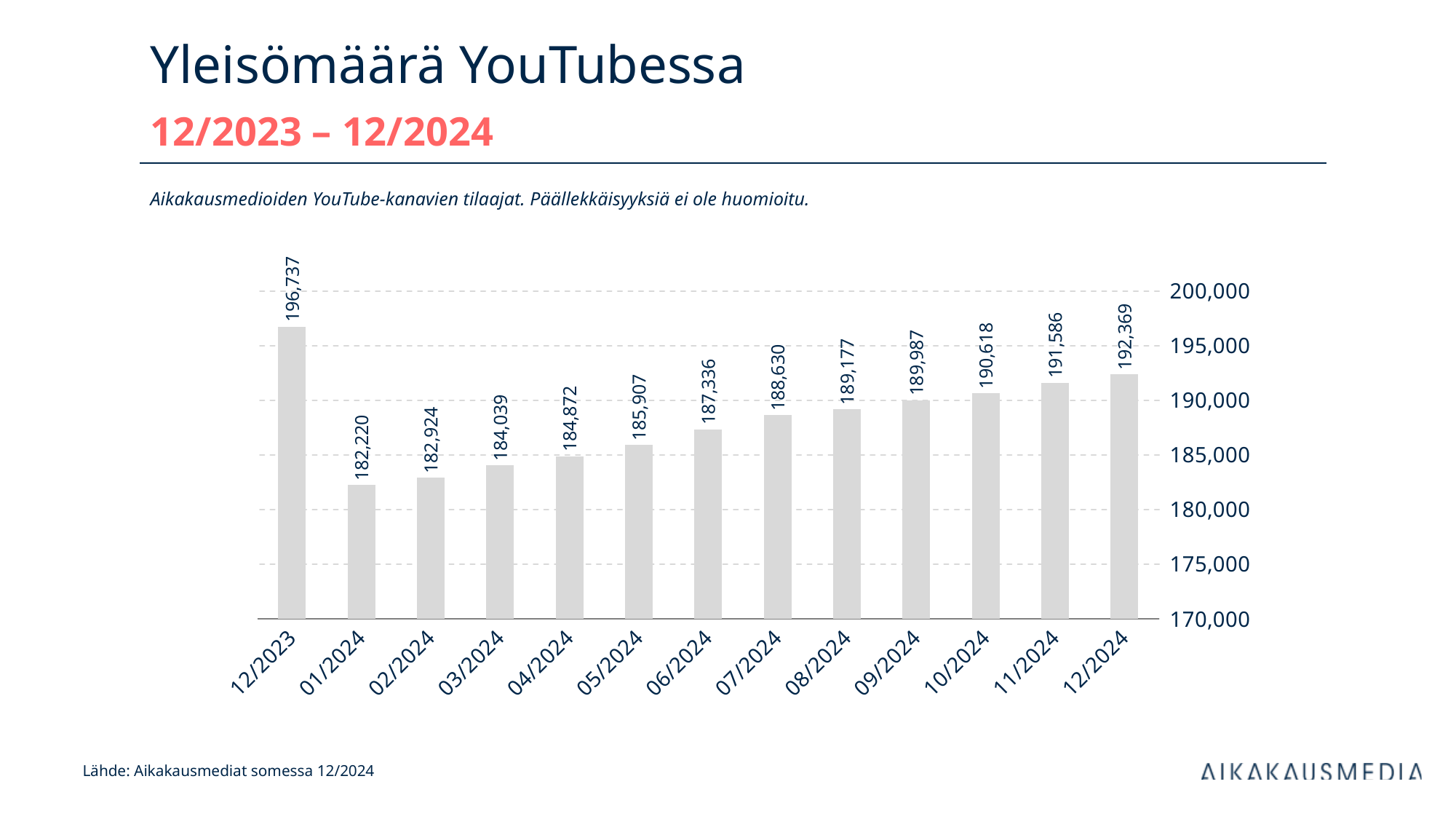
Which is larger, the value for 03/2024 or the value for 09/2024? 09/2024 What is the difference between the values for 12/2024 and 01/2024? 10,149 What is the difference between the values for 12/2023 and 12/2024? 4,368 Which month has the highest value? 12/2023 Which month has the lowest value? 01/2024 Do the values rise or fall from 01/2024 to 12/2024? rise What kind of chart is shown on the slide? bar chart What is the value for 12/2024? 192,369 Is the value for 10/2024 greater or less than 190,000? greater How many months are shown on the x axis? 13 What is the value for 06/2024? 187,336 What is the value for 12/2023? 196,737